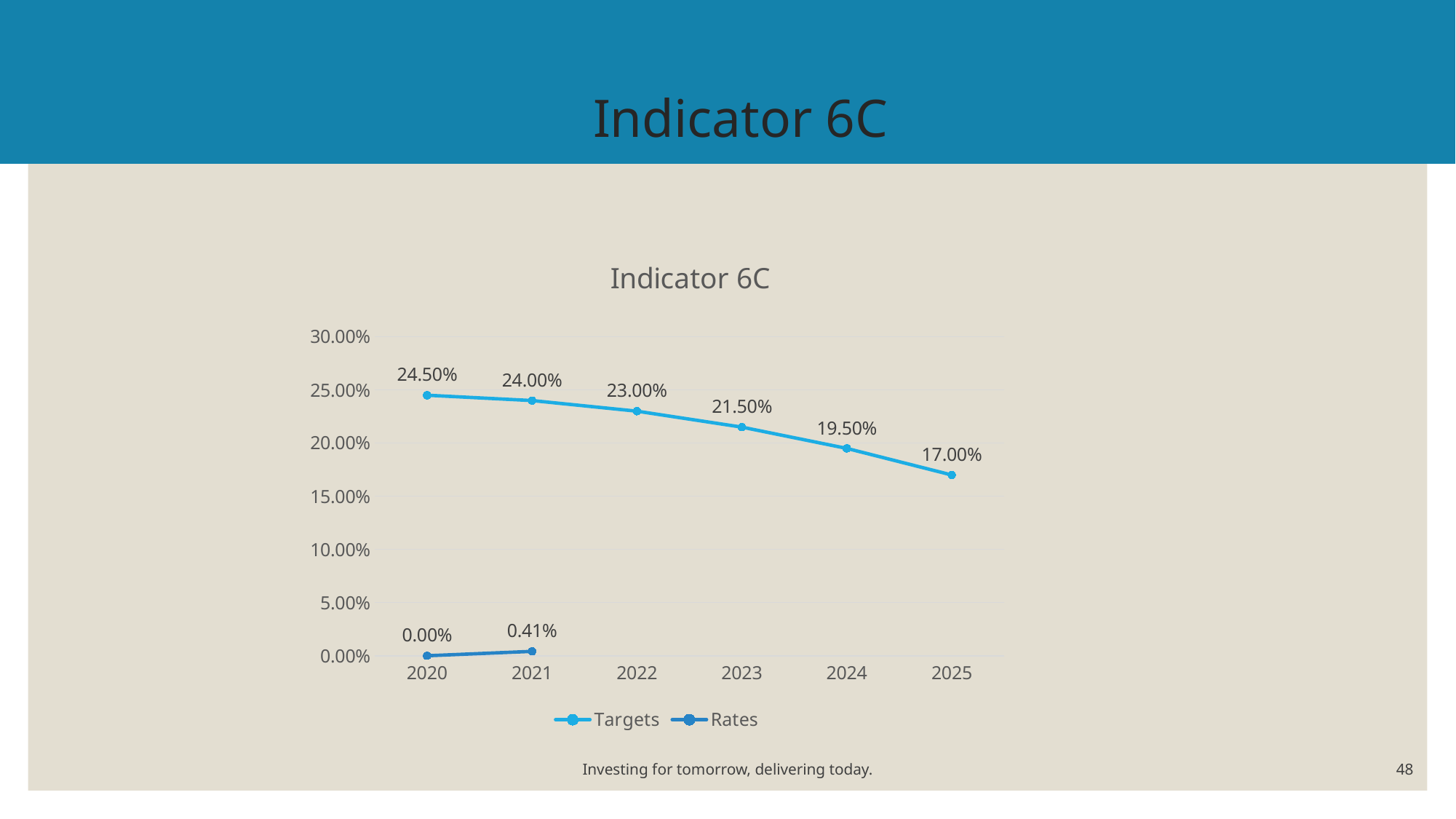
Which year has the lowest Targets value? 2025 How many series does the legend list? 2 What kind of chart is shown? line chart Which year has the highest Targets value? 2020 What is the difference between the Targets values for 2020 and 2025? 7.50% Which is larger, the Targets value for 2022 or the Targets value for 2024? 2022 What is the Targets value for 2025? 17.00% How many years are shown on the x axis? 6 What is the Rates value for 2021? 0.41% What is the Targets value for 2020? 24.50% Do the Targets values rise or fall from 2020 to 2025? fall What is the Targets value for 2023? 21.50%